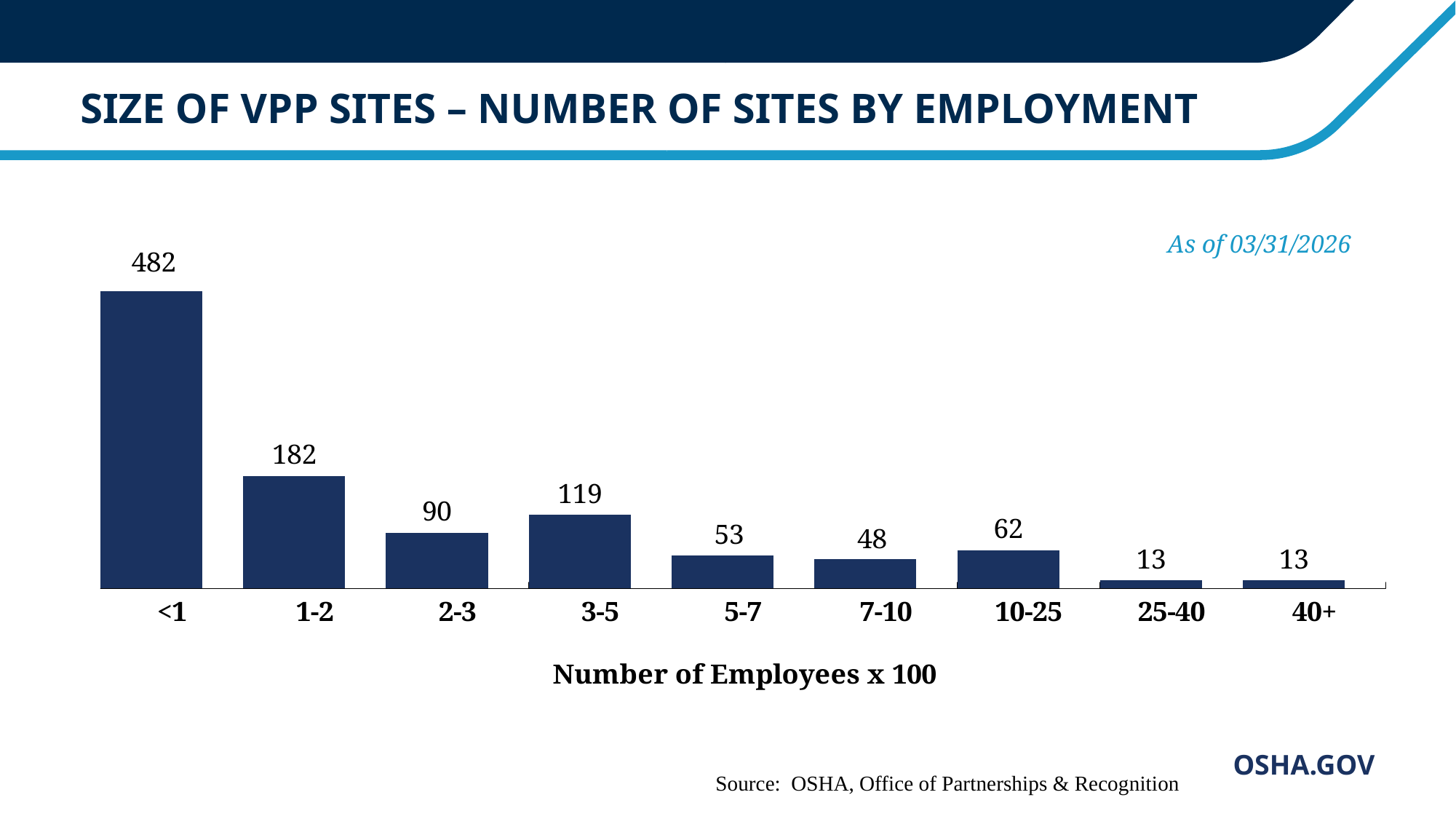
What is the number of sites in the "10-25" employment category? 62 Which employment categories are tied for the lowest number of sites? 25-40 and 40+ What is the x-axis title of the chart? Number of Employees x 100 What is the difference between the number of sites in the "<1" category and the "1-2" category? 300 What is the difference between the number of sites in the "3-5" category and the "2-3" category? 29 What is the number of sites in the "3-5" employment category? 119 Which category has more sites, "10-25" or "2-3"? 2-3 Which employment category has the highest number of sites? <1 How many employment categories are shown on the x axis? 9 What kind of chart is shown on the slide? Bar chart Which category has more sites, "5-7" or "7-10"? 5-7 How many VPP sites have fewer than 100 employees (the "<1" category)? 482